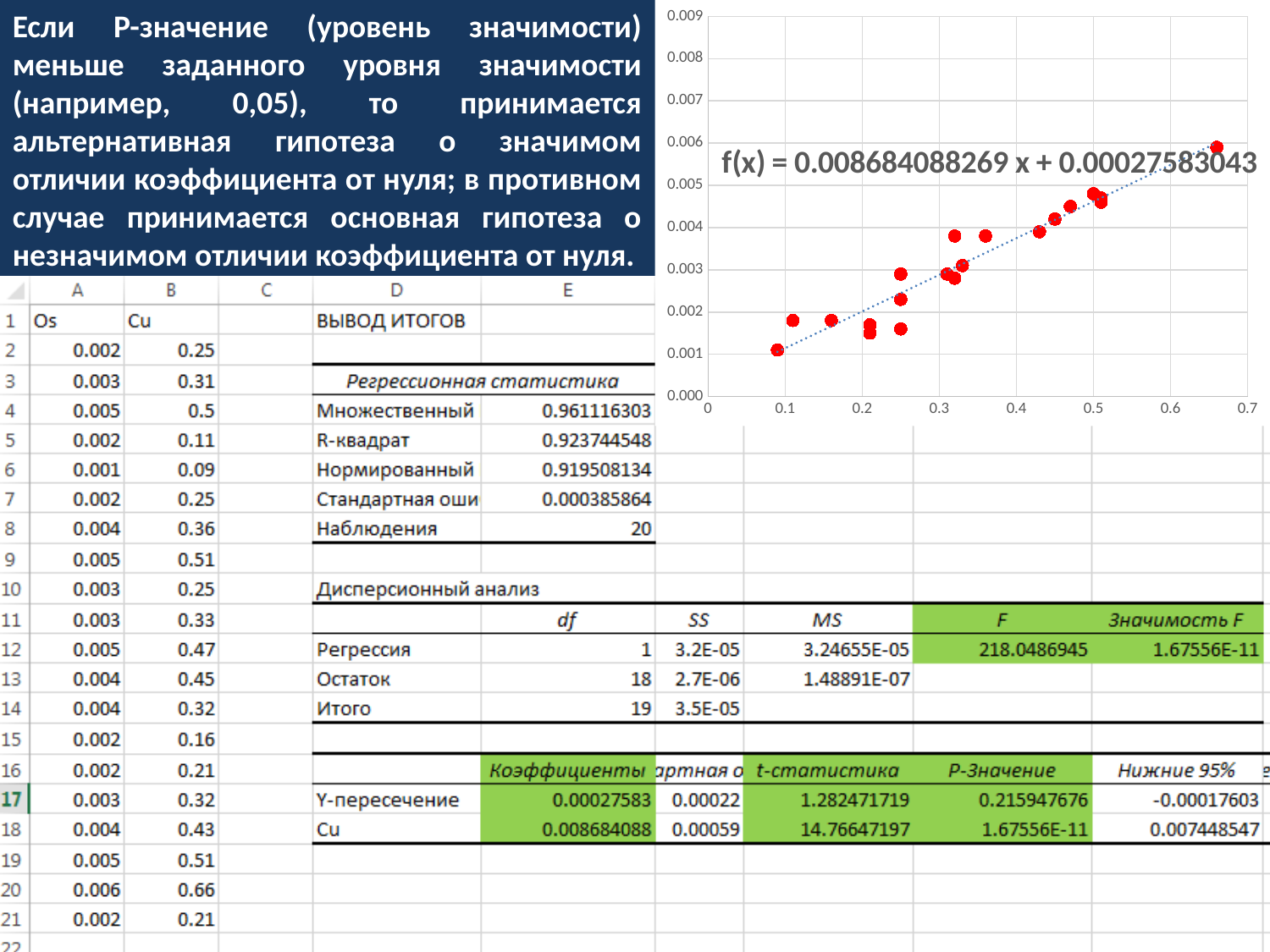
Which point has the higher y value: the one at x about 0.66 or the one at x about 0.1? the one at x about 0.66 How many observations (data points) are plotted in the chart, according to the slide? 20 Is the y value of the leftmost point (at x about 0.09) greater or less than 0.002? less What is the highest tick value shown on the x axis of the chart? 0.7 What is the lowest tick value shown on the y axis of the chart? 0.000 What trendline equation is printed on the chart? f(x) = 0.008684088269 x + 0.00027583043 Are the y values of the points near x = 0.2 greater or less than 0.003? less What kind of chart is shown on the slide? scatter chart Do the plotted points generally rise or fall as the x value increases? rise What is the slope of the trendline shown in the chart equation? 0.008684088269 Is the y value of the rightmost point (at x about 0.66) greater or less than 0.005? greater What is the highest tick value shown on the y axis of the chart? 0.009